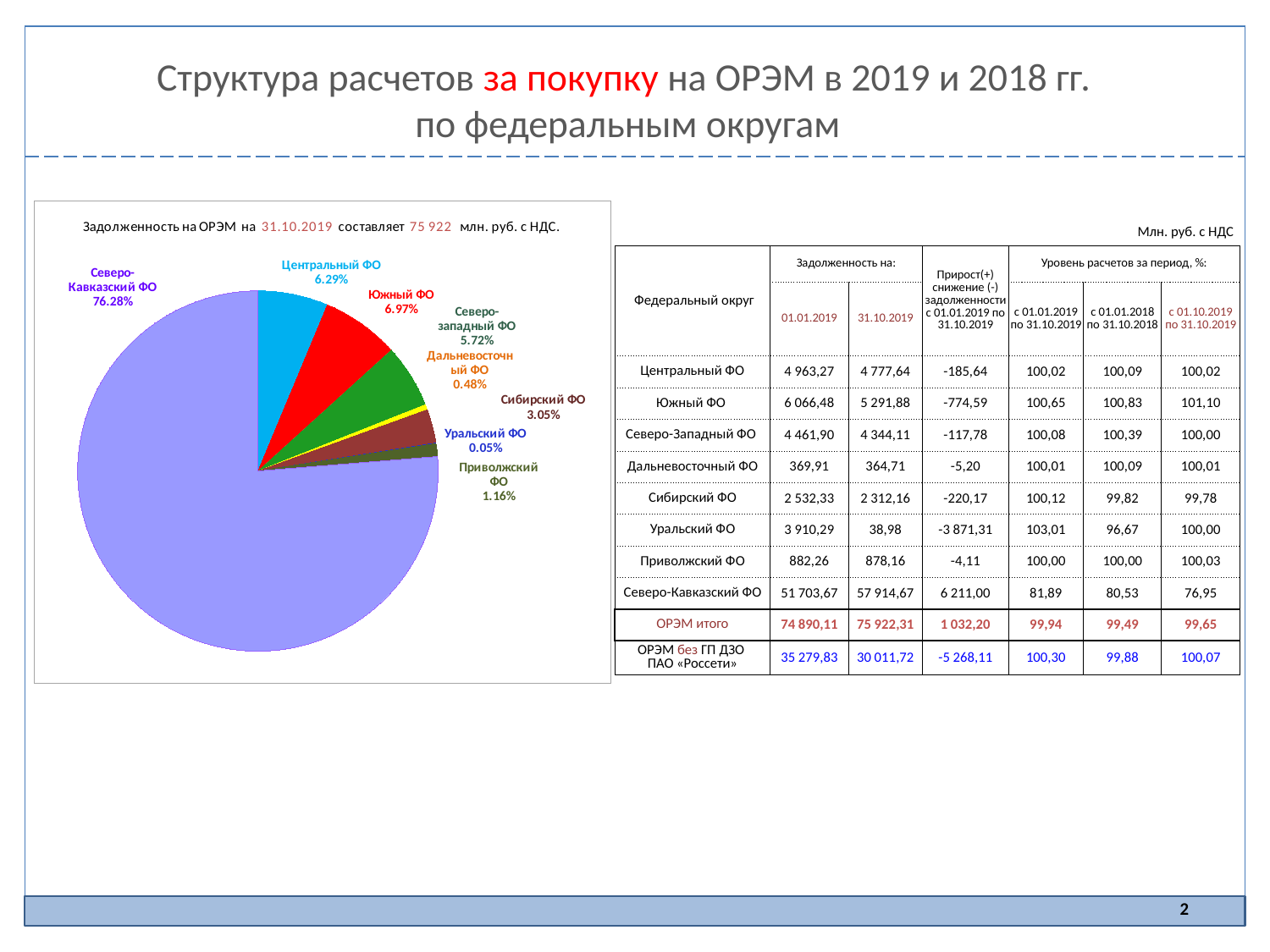
Which federal district has the smallest slice in the pie chart? Уральский ФО In the pie chart, what is the difference between the shares of Северо-западный ФО and Сибирский ФО? 2.67% According to the pie chart's title, what is the total debt on ОРЭМ as of 31.10.2019? 75 922 млн. руб. с НДС In the pie chart, which slice is larger: Южный ФО or Центральный ФО? Южный ФО In the pie chart, what share is shown for Уральский ФО? 0.05% In the pie chart, what share is shown for Северо-Кавказский ФО? 76.28% Which federal district has the largest slice in the pie chart? Северо-Кавказский ФО In the pie chart, what share is shown for Центральный ФО? 6.29% What kind of chart is shown on the left of the slide? pie chart How many slices does the pie chart have? 8 In the pie chart, what share is shown for Южный ФО? 6.97% In the pie chart, what share is shown for Сибирский ФО? 3.05%